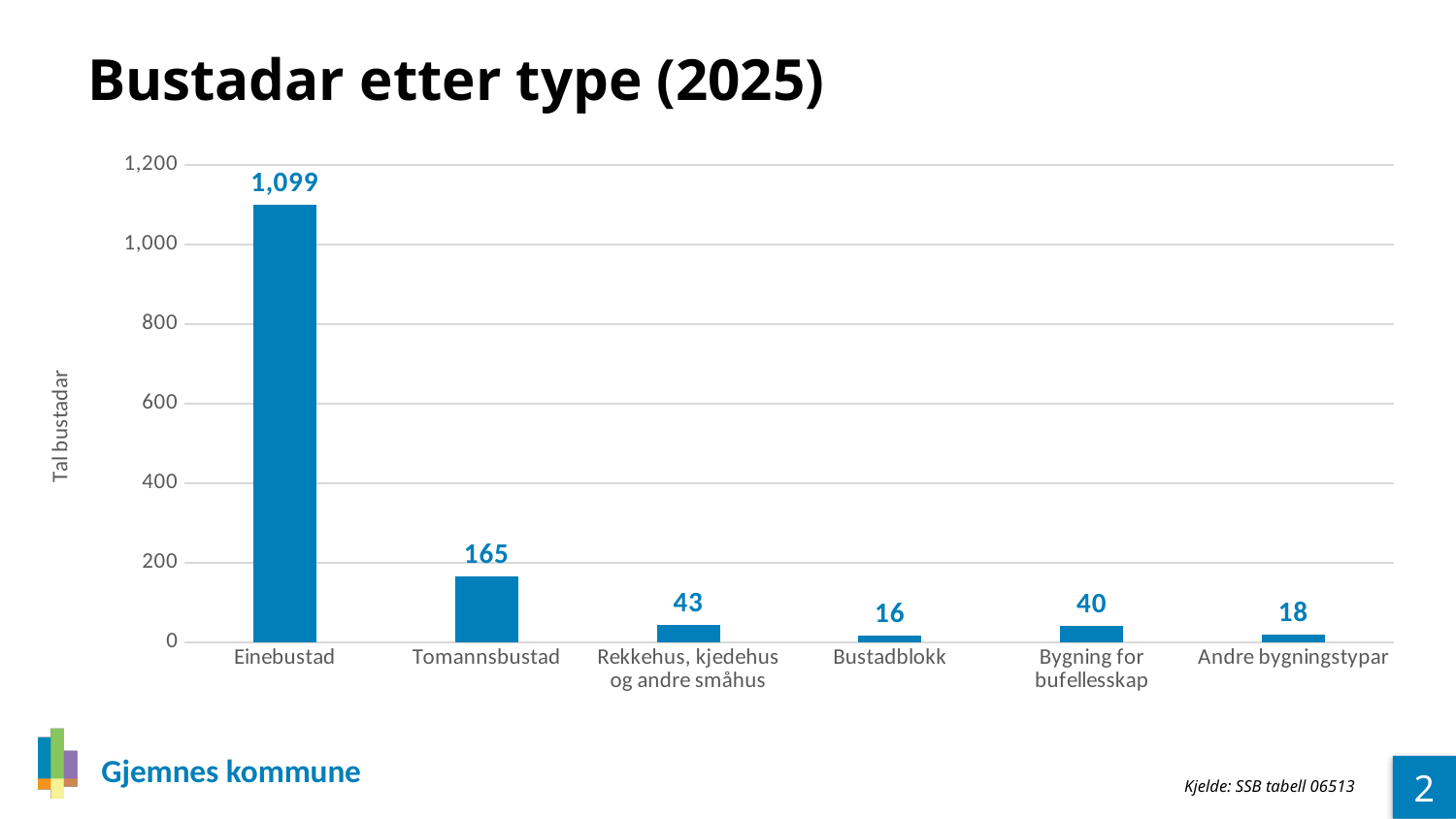
What is the value for Tomannsbustad? 165 What is the value for Bygning for bufellesskap? 40 What is the difference between Einebustad and Tomannsbustad? 934 How many categories are shown on the x axis? 6 What kind of chart is shown? Bar chart What is the value for Einebustad? 1,099 What is the value for Bustadblokk? 16 Which category has the lowest value? Bustadblokk What is the difference between Rekkehus, kjedehus og andre småhus and Bygning for bufellesskap? 3 What is the title of the chart? Bustadar etter type (2025) Which is larger, Andre bygningstypar or Bustadblokk? Andre bygningstypar Which category has the highest value? Einebustad